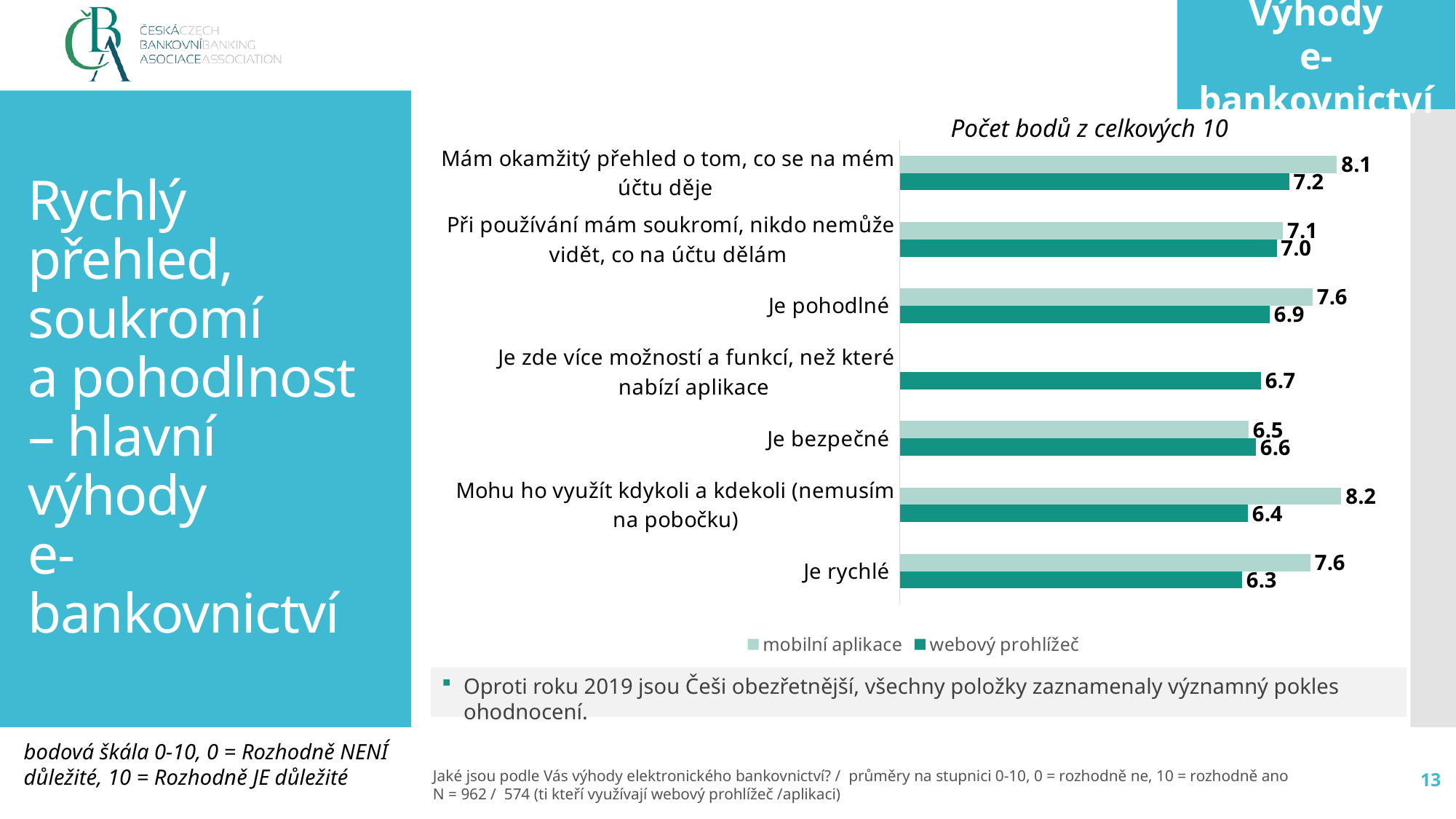
How many categories are shown on the chart? 7 Which category has the lowest value in the 'webový prohlížeč' series? Je rychlé What is the value for 'Je rychlé' in the 'webový prohlížeč' series? 6.3 Which category has the highest value in the 'mobilní aplikace' series? Mohu ho využít kdykoli a kdekoli (nemusím na pobočku) What kind of chart is shown on the slide? bar chart What is the 'webový prohlížeč' value for 'Je zde více možností a funkcí, než které nabízí aplikace'? 6.7 What is the difference between the 'mobilní aplikace' and 'webový prohlížeč' values for 'Mohu ho využít kdykoli a kdekoli (nemusím na pobočku)'? 1.8 What is the title of the chart? Počet bodů z celkových 10 How many series does the legend list? 2 What is the value for 'Je pohodlné' in the 'mobilní aplikace' series? 7.6 What is the 'webový prohlížeč' value for 'Mám okamžitý přehled o tom, co se na mém účtu děje'? 7.2 For 'Je bezpečné', which series has the larger value: 'mobilní aplikace' or 'webový prohlížeč'? webový prohlížeč